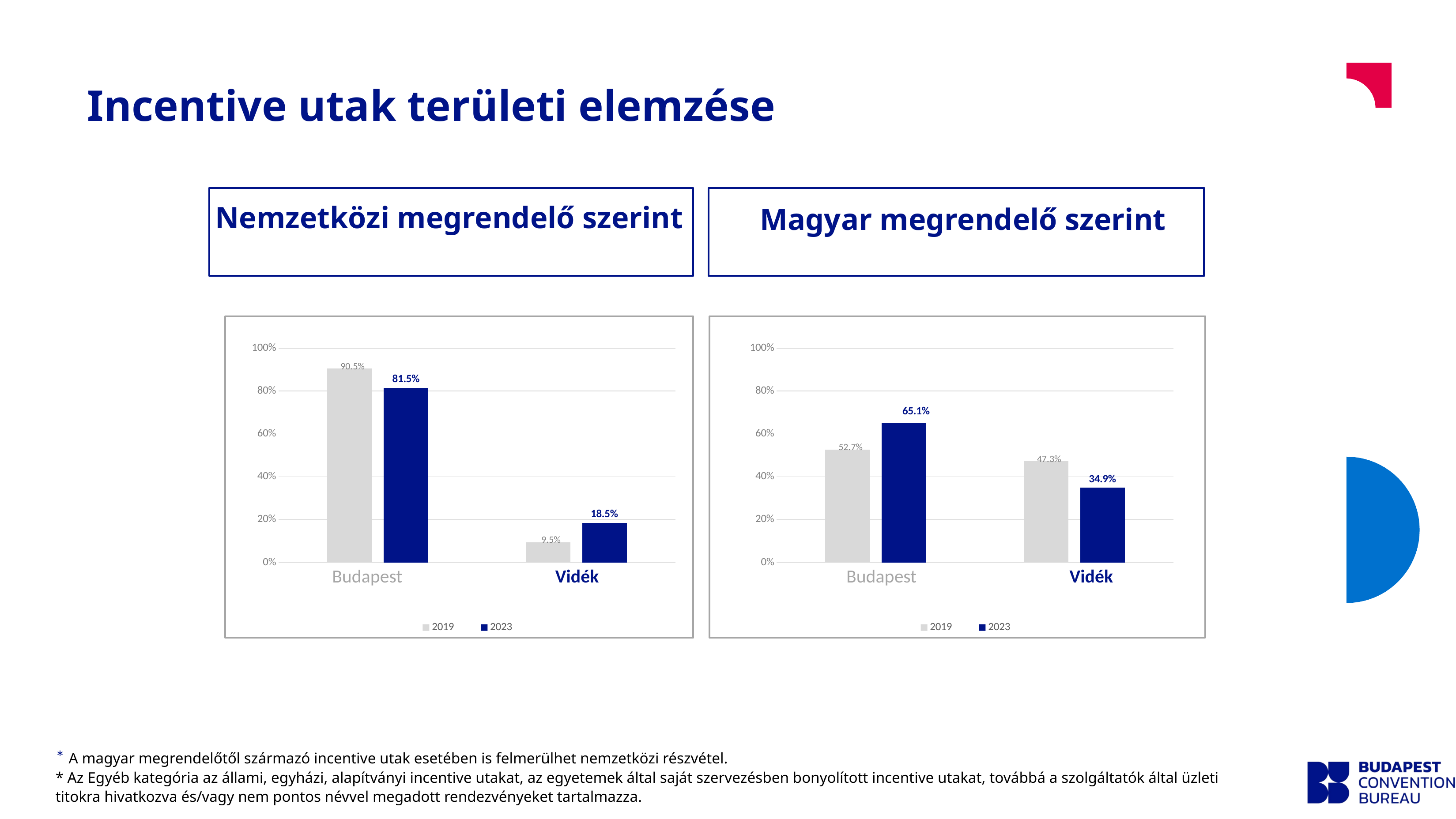
In the 'Magyar megrendelő szerint' chart, what is the difference between the Vidék values for 2019 and 2023? 12.4 percentage points What kind of chart is the 'Magyar megrendelő szerint' chart? Bar chart In the 'Nemzetközi megrendelő szerint' chart, what is the difference between the Budapest values for 2019 and 2023? 9 percentage points In the 'Magyar megrendelő szerint' chart, which category has the highest value in 2023? Budapest In the 'Nemzetközi megrendelő szerint' chart, which category has the lowest value in 2019? Vidék How many categories are shown on the x axis of the 'Magyar megrendelő szerint' chart? 2 In the 'Nemzetközi megrendelő szerint' chart, what is the value for Vidék in 2023? 18.5% In the 'Magyar megrendelő szerint' chart, what is the value for Vidék in 2019? 47.3% In the 'Magyar megrendelő szerint' chart, which is larger for Budapest: the 2019 value or the 2023 value? 2023 In the 'Magyar megrendelő szerint' chart, what is the value for Budapest in 2023? 65.1% How many series does the legend of the 'Nemzetközi megrendelő szerint' chart list? 2 In the 'Nemzetközi megrendelő szerint' chart, what is the value for Budapest in 2019? 90.5%